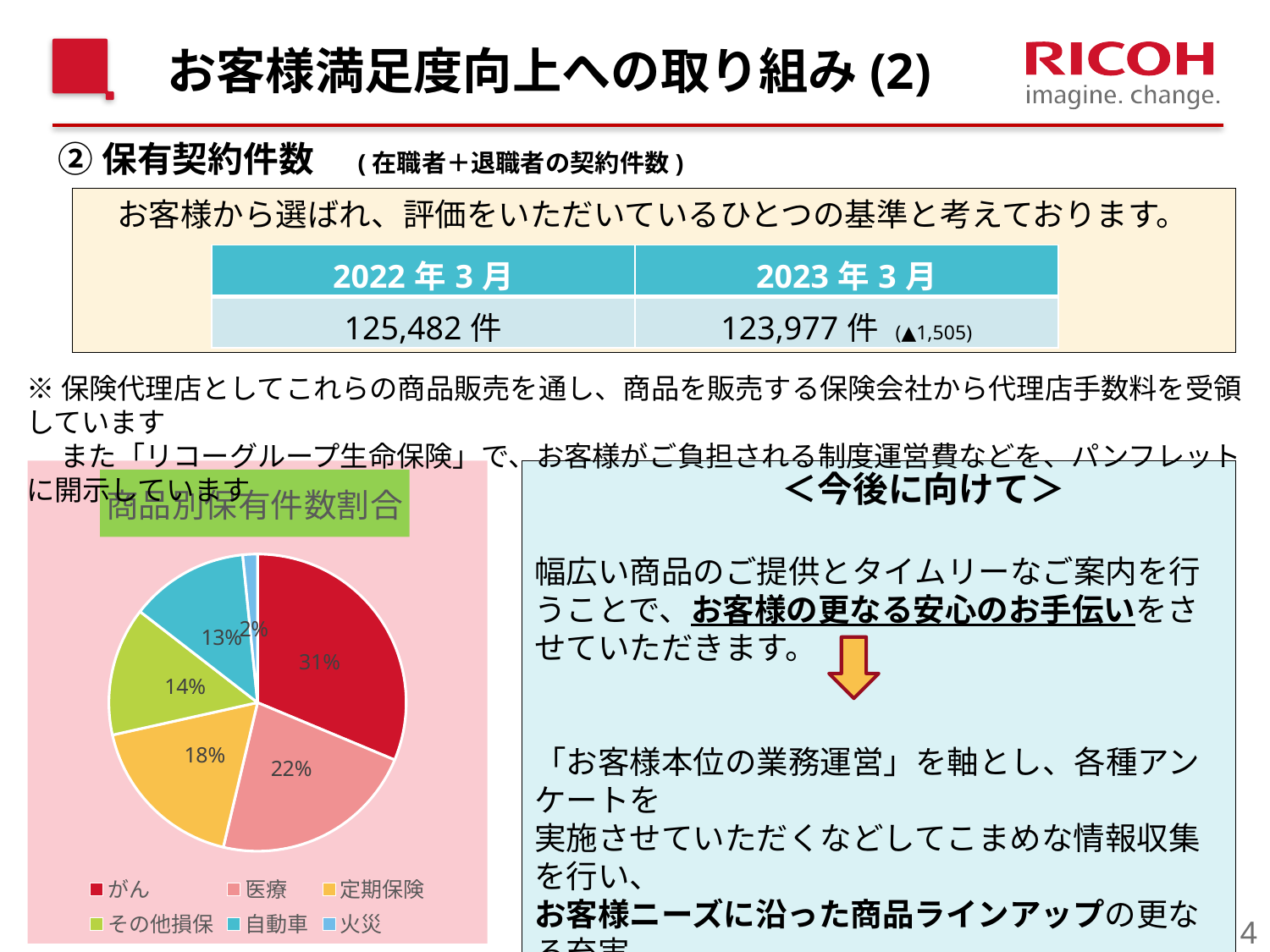
What share of the pie does 火災 account for? 2% What is the title of the pie chart? 商品別保有件数割合 What kind of chart is shown on the slide? Pie chart Which category has the largest slice of the pie? がん Which is larger, the share for 定期保険 or the share for 自動車? 定期保険 What share of the pie does その他損保 account for? 14% What is the difference in percentage points between がん and 医療? 9 What share of the pie does 医療 account for? 22% Which category has the smallest slice of the pie? 火災 How many categories does the pie chart show? 6 What share of the pie does 定期保険 account for? 18% What share of the pie does がん account for? 31%